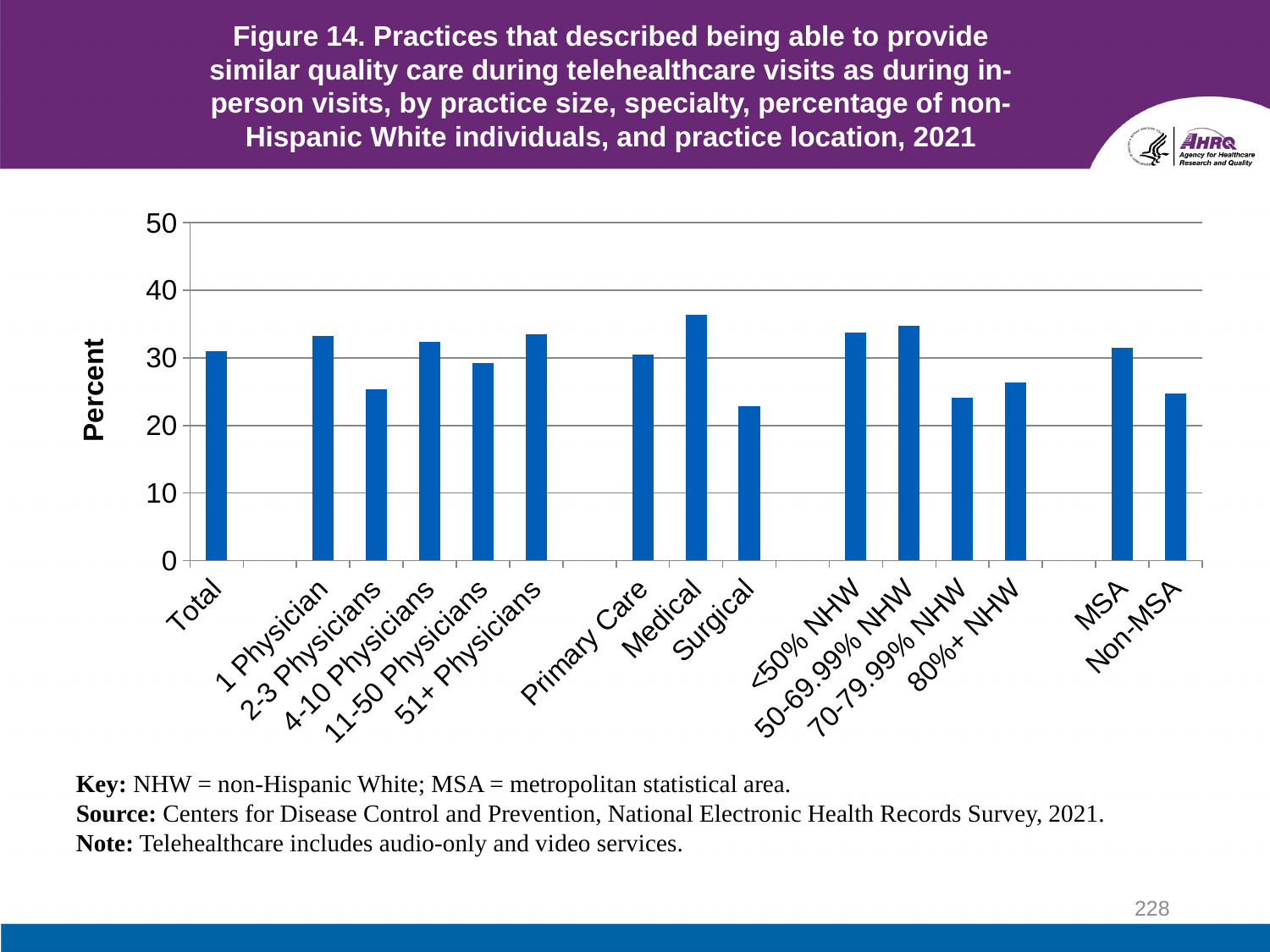
What kind of chart is shown on the slide? bar chart Is the value for 2-3 Physicians greater or less than 30? less Is the value for Non-MSA greater or less than 30? less Which is larger, the value for Primary Care or the value for Surgical? Primary Care How many bars (categories) are plotted in the chart? 15 Which is larger, the value for MSA or the value for Non-MSA? MSA What is the label on the vertical axis of the chart? Percent Is the value for 1 Physician greater or less than 30? greater Which is larger, the value for 1 Physician or the value for 2-3 Physicians? 1 Physician Which category has the highest bar in the chart? Medical